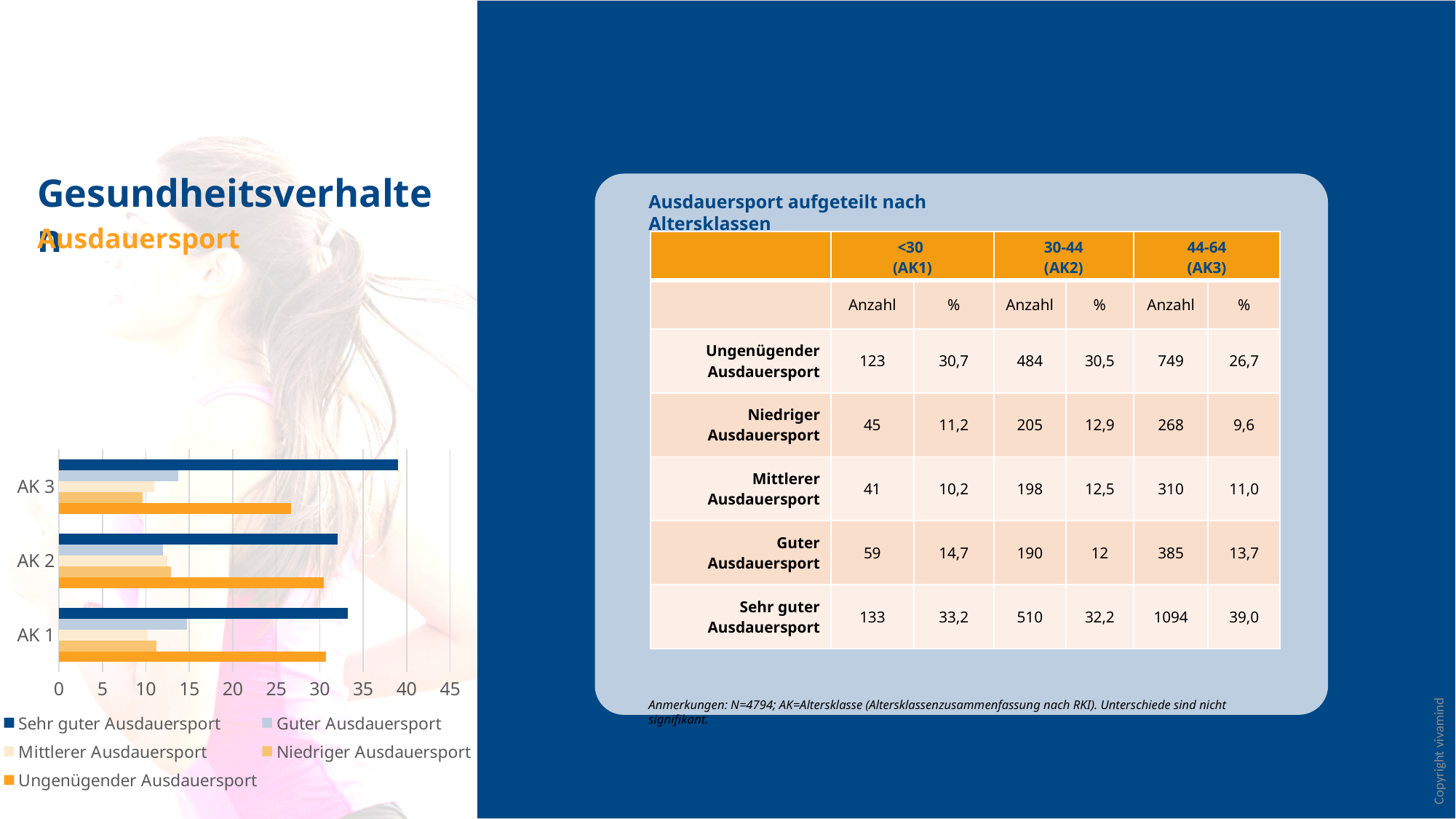
In the bar chart, which is larger for AK 3: Sehr guter Ausdauersport or Ungenügender Ausdauersport? Sehr guter Ausdauersport In the bar chart, which category has the shortest bar for Ungenügender Ausdauersport? AK 3 What type of chart is shown on the left of the slide? bar chart In the bar chart, is the value for Guter Ausdauersport in AK 1 greater or less than 20? less In the bar chart, which category has the longest bar for Sehr guter Ausdauersport? AK 3 What colour represents Sehr guter Ausdauersport in the bar chart legend? dark blue In the bar chart, is the value for Niedriger Ausdauersport in AK 3 greater or less than 15? less In the bar chart, is the value for Ungenügender Ausdauersport in AK 3 greater or less than 30? less How many series does the legend of the bar chart list? 5 In the bar chart, which series has the longest bar for AK 3? Sehr guter Ausdauersport How many age-class categories (AK) are shown on the bar chart? 3